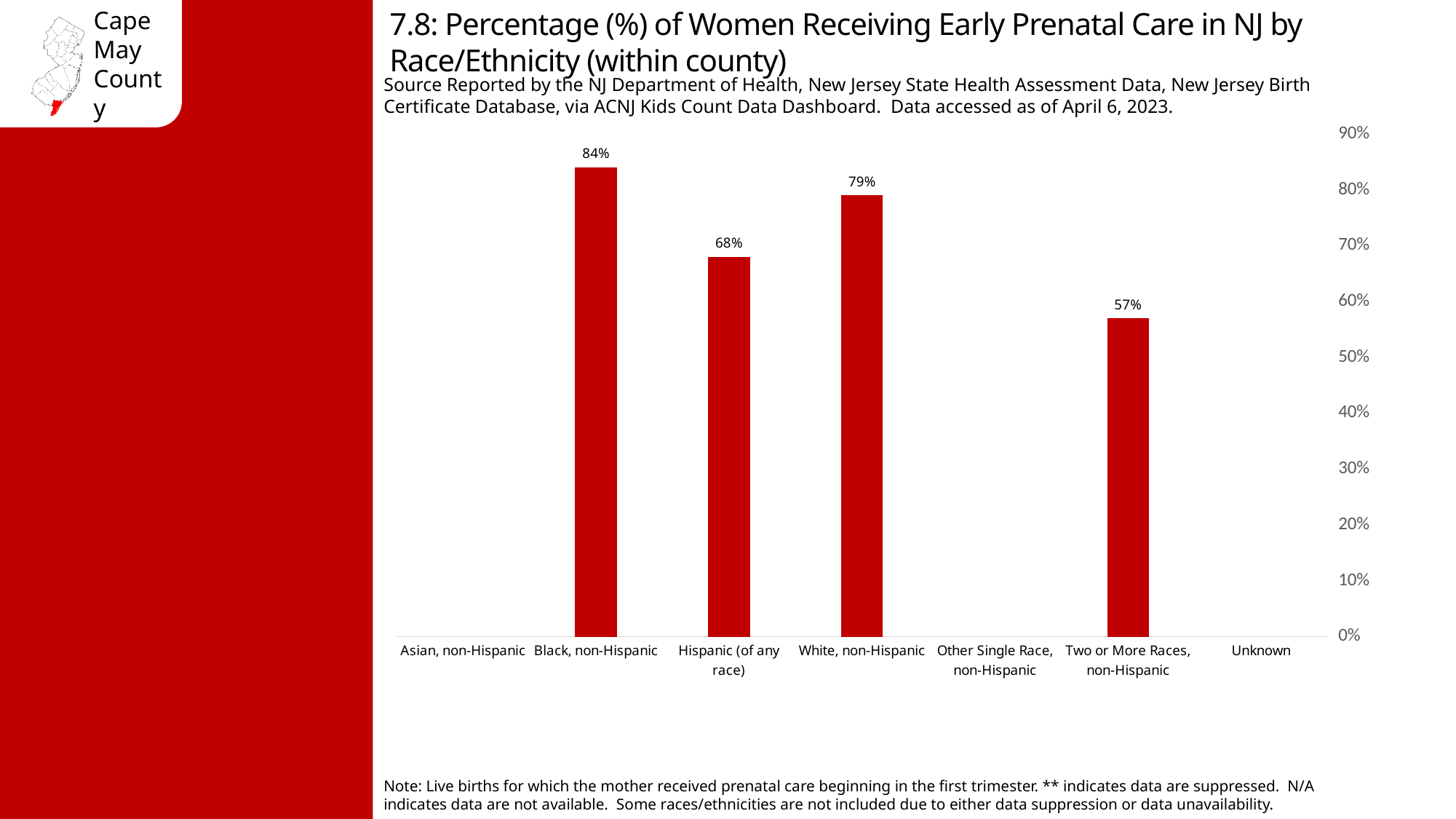
What type of chart is shown on the slide? Bar chart Which race/ethnicity category has the highest percentage of women receiving early prenatal care? Black, non-Hispanic What is the difference between the Hispanic (of any race) and Two or More Races, non-Hispanic values? 11% How many race/ethnicity categories are labeled on the x axis? 7 Among the categories with a plotted bar, which has the lowest percentage? Two or More Races, non-Hispanic What percentage is shown for White, non-Hispanic women? 79% What is the difference between the Black, non-Hispanic and White, non-Hispanic percentages? 5% What is the value for Two or More Races, non-Hispanic? 57% Which is larger, the value for Hispanic (of any race) or for White, non-Hispanic? White, non-Hispanic What is the value shown for Hispanic (of any race)? 68% What percentage of Black, non-Hispanic women received early prenatal care? 84% How many categories have a bar plotted on the chart? 4